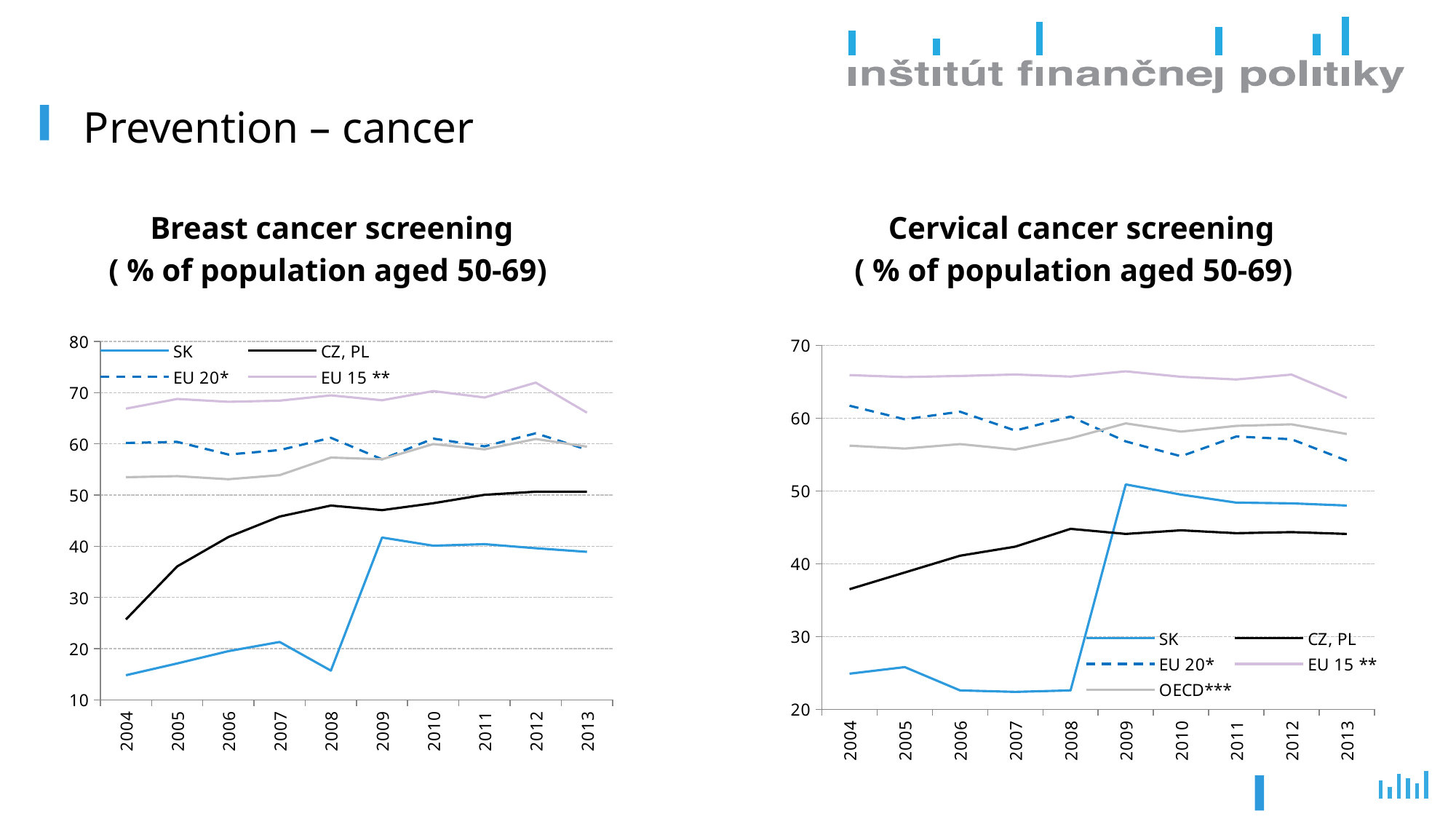
In the Breast cancer screening chart, which series has the highest value in 2013? EU 15 ** In the Breast cancer screening chart, does the CZ, PL line rise or fall from 2004 to 2013? rises In the Cervical cancer screening chart, which series has the lowest value in 2013? CZ, PL How many series does the legend of the Cervical cancer screening chart list? 5 In the Cervical cancer screening chart, which is larger in 2013, SK or CZ, PL? SK In the Breast cancer screening chart, is the value for EU 15 ** in 2013 greater or less than 60? greater In the Breast cancer screening chart, is the value for SK in 2009 greater or less than 30? greater In the Cervical cancer screening chart, is the value for SK in 2008 greater or less than 30? less How many series does the legend of the Breast cancer screening chart list? 4 What kind of chart is the Breast cancer screening chart? line chart How many years are shown on the x axis of the Cervical cancer screening chart? 10